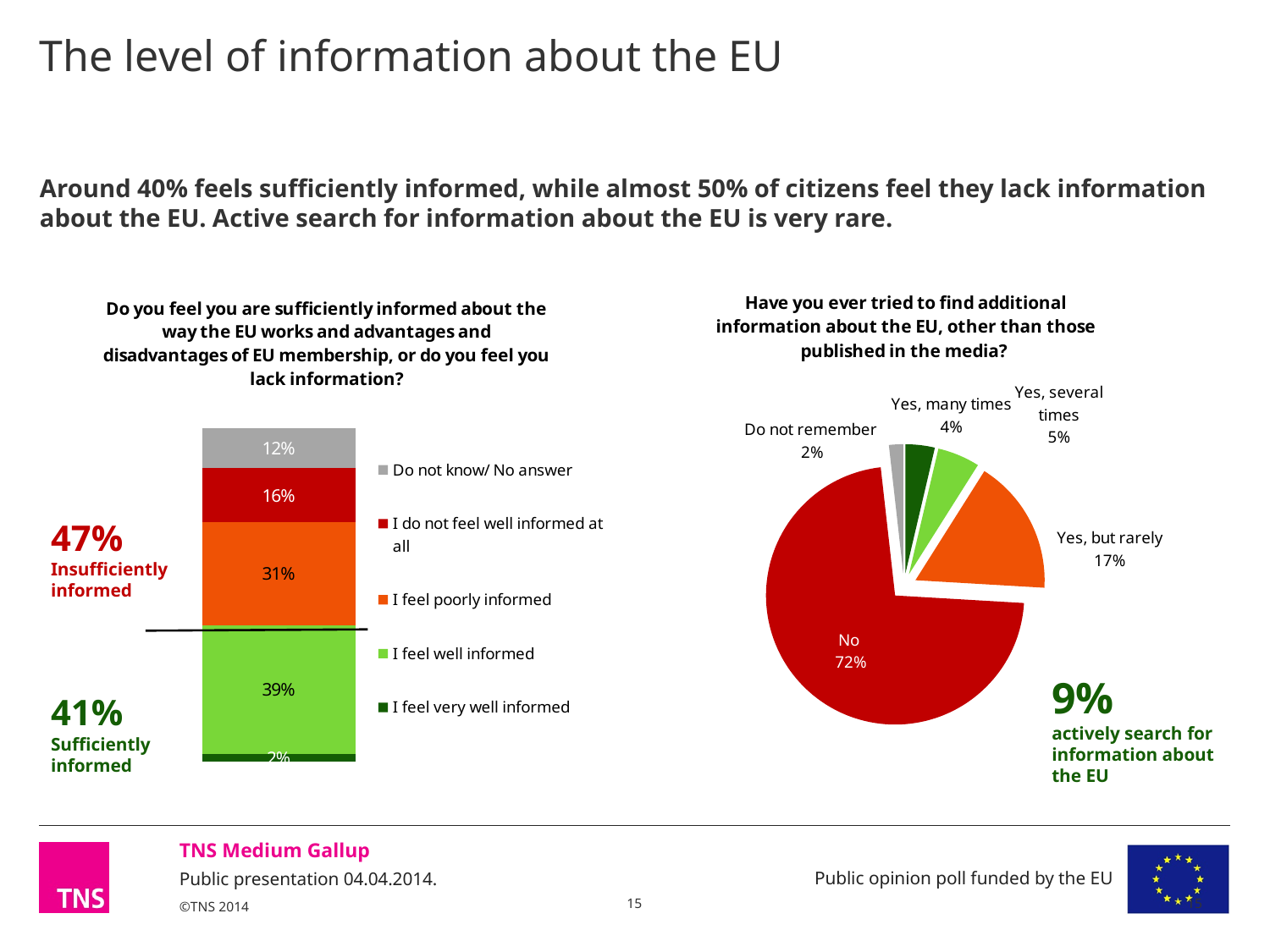
In the left chart ("Do you feel you are sufficiently informed..."), what is the difference between "I feel well informed" and "I do not feel well informed at all"? 23 percentage points How many slices does the right pie chart ("Have you ever tried to find additional information about the EU...") have? 5 What kind of chart is the left chart ("Do you feel you are sufficiently informed...")? Stacked bar chart In the left chart ("Do you feel you are sufficiently informed..."), how many entries does the legend list? 5 In the right chart ("Have you ever tried to find additional information about the EU..."), what percentage answered "Yes, but rarely"? 17% In the right chart ("Have you ever tried to find additional information about the EU..."), which is larger: "Yes, several times" or "Yes, many times"? Yes, several times In the left chart ("Do you feel you are sufficiently informed..."), what percentage of respondents said "I feel poorly informed"? 31% What kind of chart is the right chart ("Have you ever tried to find additional information about the EU...")? Pie chart In the left chart ("Do you feel you are sufficiently informed..."), which response has the smallest share? I feel very well informed In the right chart ("Have you ever tried to find additional information about the EU..."), what percentage answered "No"? 72% In the left chart ("Do you feel you are sufficiently informed..."), what percentage answered "Do not know/ No answer"? 12% In the left chart ("Do you feel you are sufficiently informed..."), what percentage of respondents said "I feel well informed"? 39%